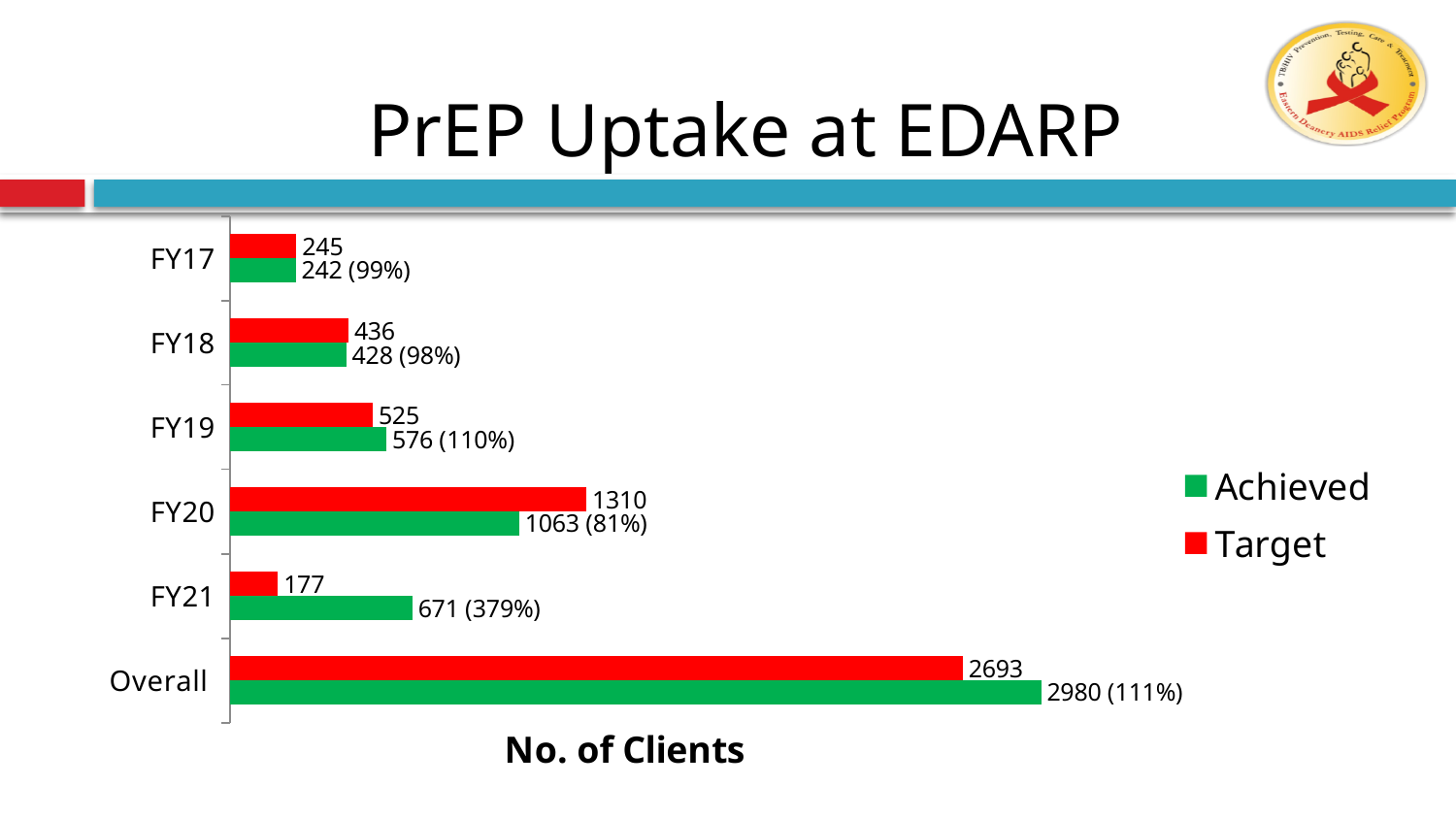
What is the Achieved value for FY19? 576 (110%) For FY18, which is larger, the Target or the Achieved value? Target Which fiscal year (excluding Overall) has the lowest Target value? FY21 For FY21, which is larger, the Target or the Achieved value? Achieved How many categories are shown on the vertical axis? 6 What is the difference between the Target and Achieved values for FY20? 247 What is the Target value for FY20? 1310 Which fiscal year (excluding Overall) has the highest Achieved value? FY20 How many series does the legend list? 2 What is the Achieved value for FY21? 671 (379%) What kind of chart is shown on the slide? Bar chart What is the label of the horizontal axis? No. of Clients